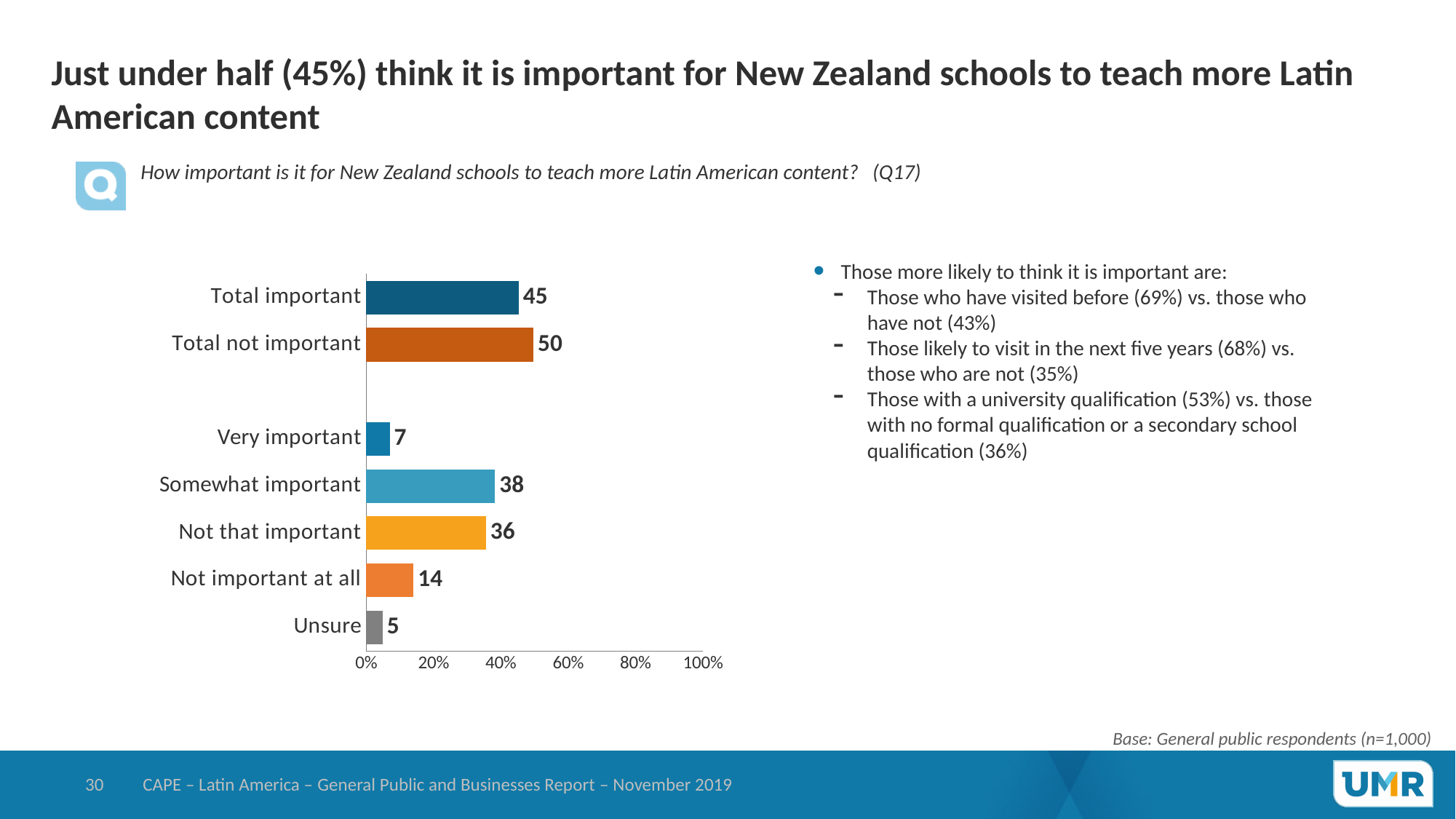
Is the value for Total not important greater or less than 40%? greater Which is larger, Somewhat important or Not that important? Somewhat important How many categories are shown in the chart? 7 Which category has the lowest value? Unsure What is the value for Somewhat important? 38 What is the value for Unsure? 5 What kind of chart is shown on the slide? Bar chart What is the difference between Total not important and Total important? 5 What is the difference between Somewhat important and Very important? 31 What is the value for Total important? 45 Which category has the highest value? Total not important What is the value for Not important at all? 14